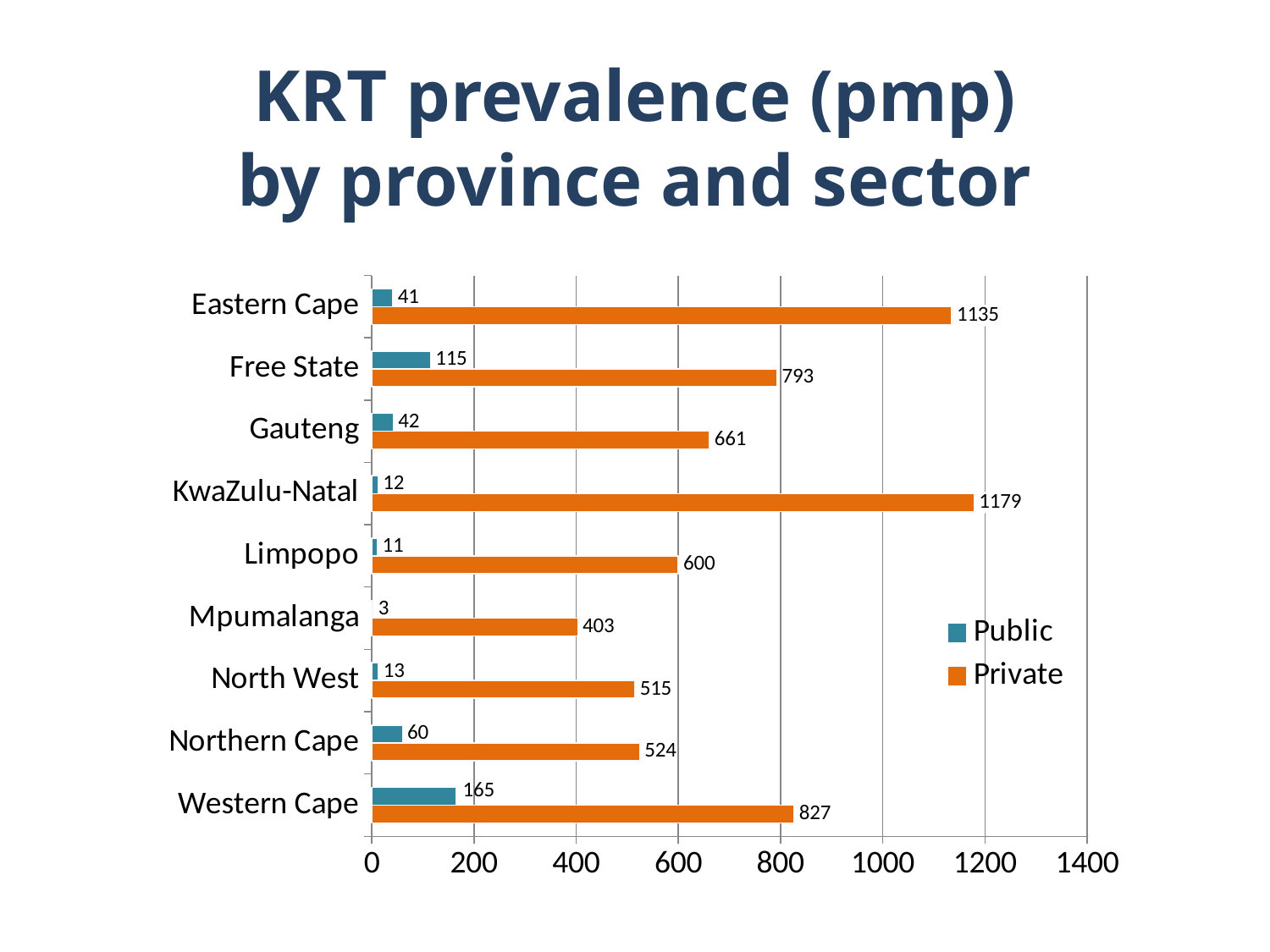
Which colour represents the Private sector in the chart? Orange Which is larger, the Private value for Free State or the Private value for Western Cape? Western Cape What is the difference between the Private and Public values for Eastern Cape? 1094 What is the Private KRT prevalence for KwaZulu-Natal? 1179 Which province has the lowest Public KRT prevalence? Mpumalanga What is the Public KRT prevalence for Western Cape? 165 Which province has the highest Private KRT prevalence? KwaZulu-Natal How many provinces are shown on the chart? 9 How many series does the legend list? 2 Which province has the highest Public KRT prevalence? Western Cape What kind of chart is shown on the slide? Bar chart What is the Private value for Mpumalanga? 403